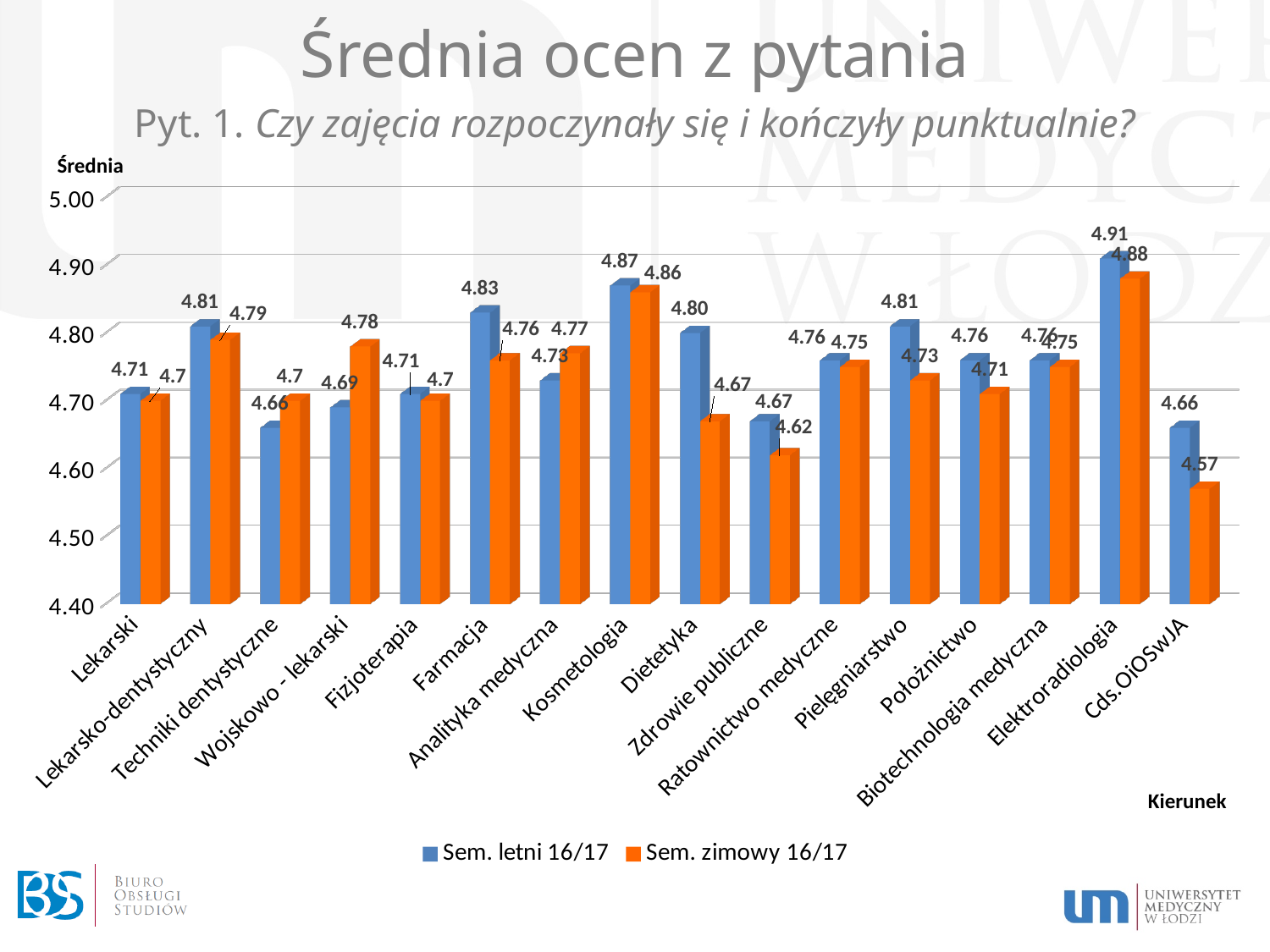
What is the value for Dietetyka in the Sem. zimowy 16/17 series? 4.67 Which category has the lowest value in the Sem. zimowy 16/17 series? Cds.OiOSwJA What is the label of the y axis? Średnia Which is larger for Analityka medyczna: the Sem. letni 16/17 value or the Sem. zimowy 16/17 value? Sem. zimowy 16/17 How many series does the legend list? 2 Which category has the highest value in the Sem. letni 16/17 series? Elektroradiologia What is the value for Wojskowo - lekarski in the Sem. zimowy 16/17 series? 4.78 What is the difference between the Sem. letni 16/17 and Sem. zimowy 16/17 values for Dietetyka? 0.13 What is the value for Farmacja in the Sem. letni 16/17 series? 4.83 How many categories (kierunki) are shown on the x axis? 16 Is the Sem. zimowy 16/17 value for Zdrowie publiczne greater or less than 4.70? less What kind of chart is shown on the slide? bar chart